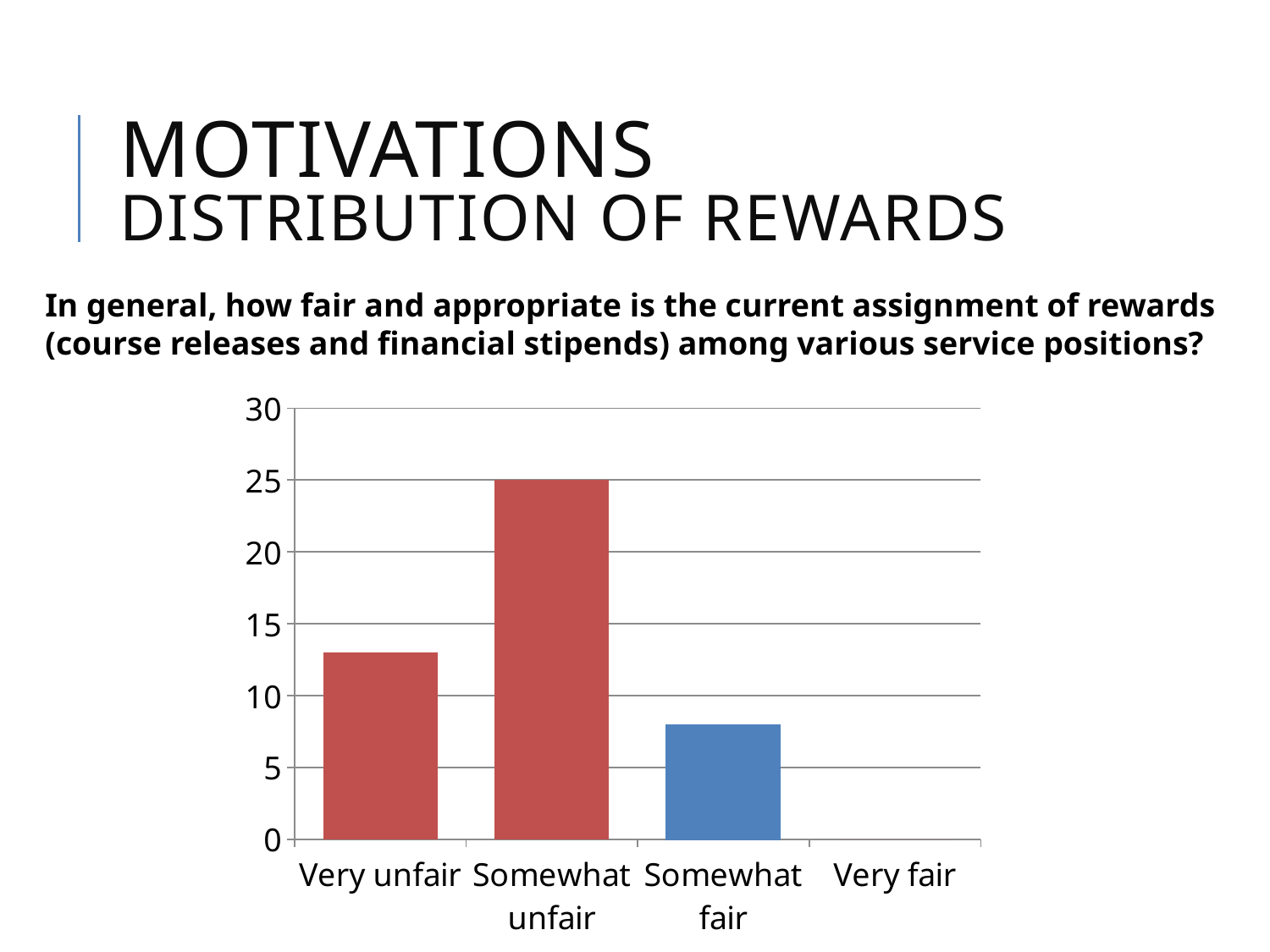
Is the value for Somewhat fair greater or less than 10? less How many categories are shown on the x axis of the chart? 4 Is the value for Very unfair greater or less than 15? less What is the difference between the values for Somewhat unfair and Very fair? 25 What is the value for Somewhat unfair? 25 Which category has the lowest value in the chart? Very fair Is the value for Very unfair greater or less than 10? greater What is the value for Very fair? 0 Which is larger, the value for Very unfair or the value for Somewhat fair? Very unfair What is the highest value shown on the y axis of the chart? 30 What kind of chart is shown on the slide? bar chart Which category has the highest bar in the chart? Somewhat unfair